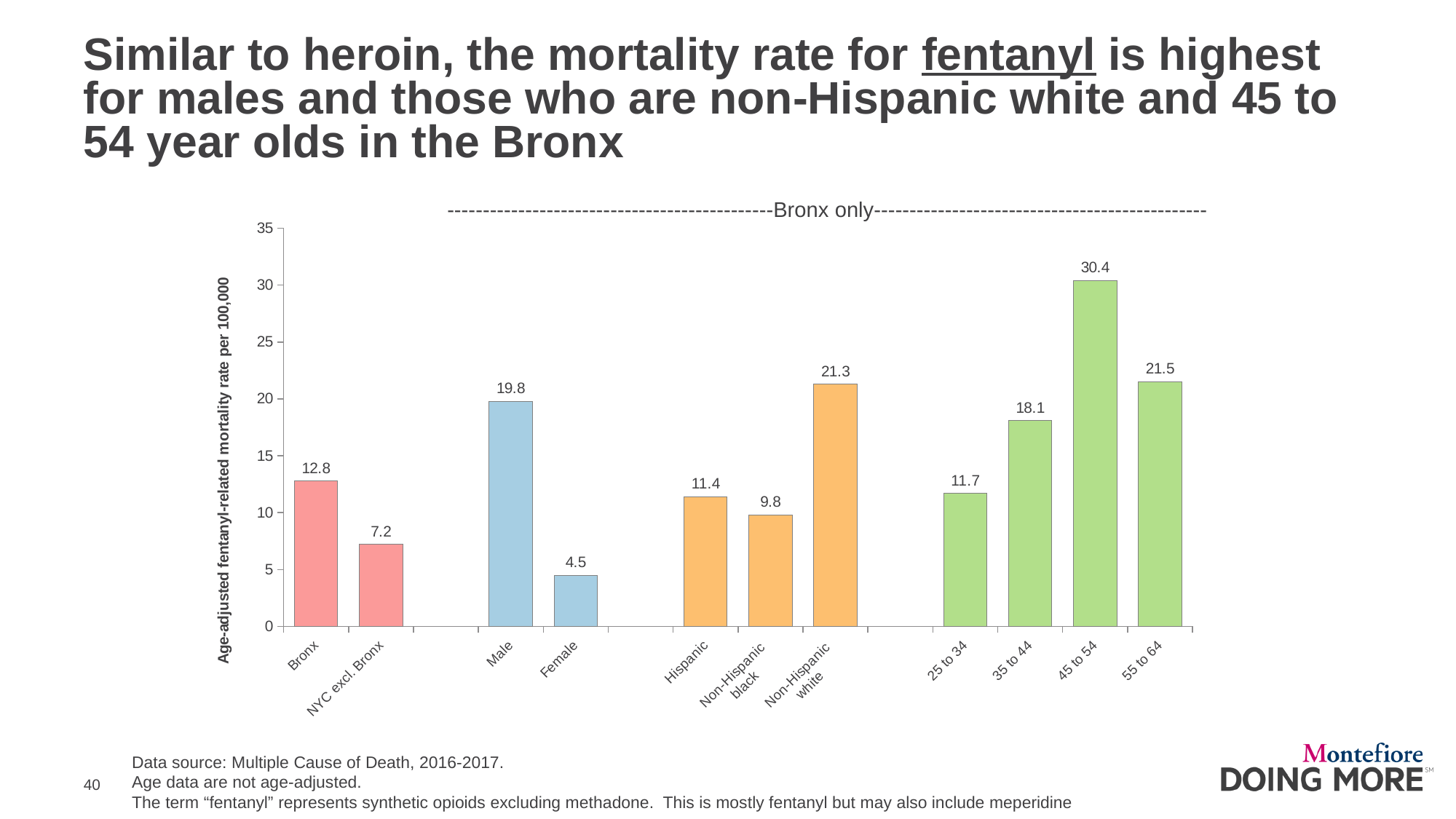
What is the age-adjusted fentanyl-related mortality rate per 100,000 for the Bronx? 12.8 What is the fentanyl-related mortality rate for NYC excl. Bronx? 7.2 What is the fentanyl-related mortality rate for Females in the Bronx? 4.5 What type of chart is shown on the slide? Bar chart What is the difference between the Male and Female fentanyl-related mortality rates? 15.3 How many bars are plotted on the chart? 11 Which has a higher fentanyl-related mortality rate, Hispanic or Non-Hispanic black? Hispanic Which category on the chart has the highest fentanyl-related mortality rate? 45 to 54 What is the fentanyl-related mortality rate for Non-Hispanic white residents of the Bronx? 21.3 What is the label on the vertical axis of the chart? Age-adjusted fentanyl-related mortality rate per 100,000 What is the difference between the Bronx and NYC excl. Bronx fentanyl-related mortality rates? 5.6 Which category on the chart has the lowest fentanyl-related mortality rate? Female